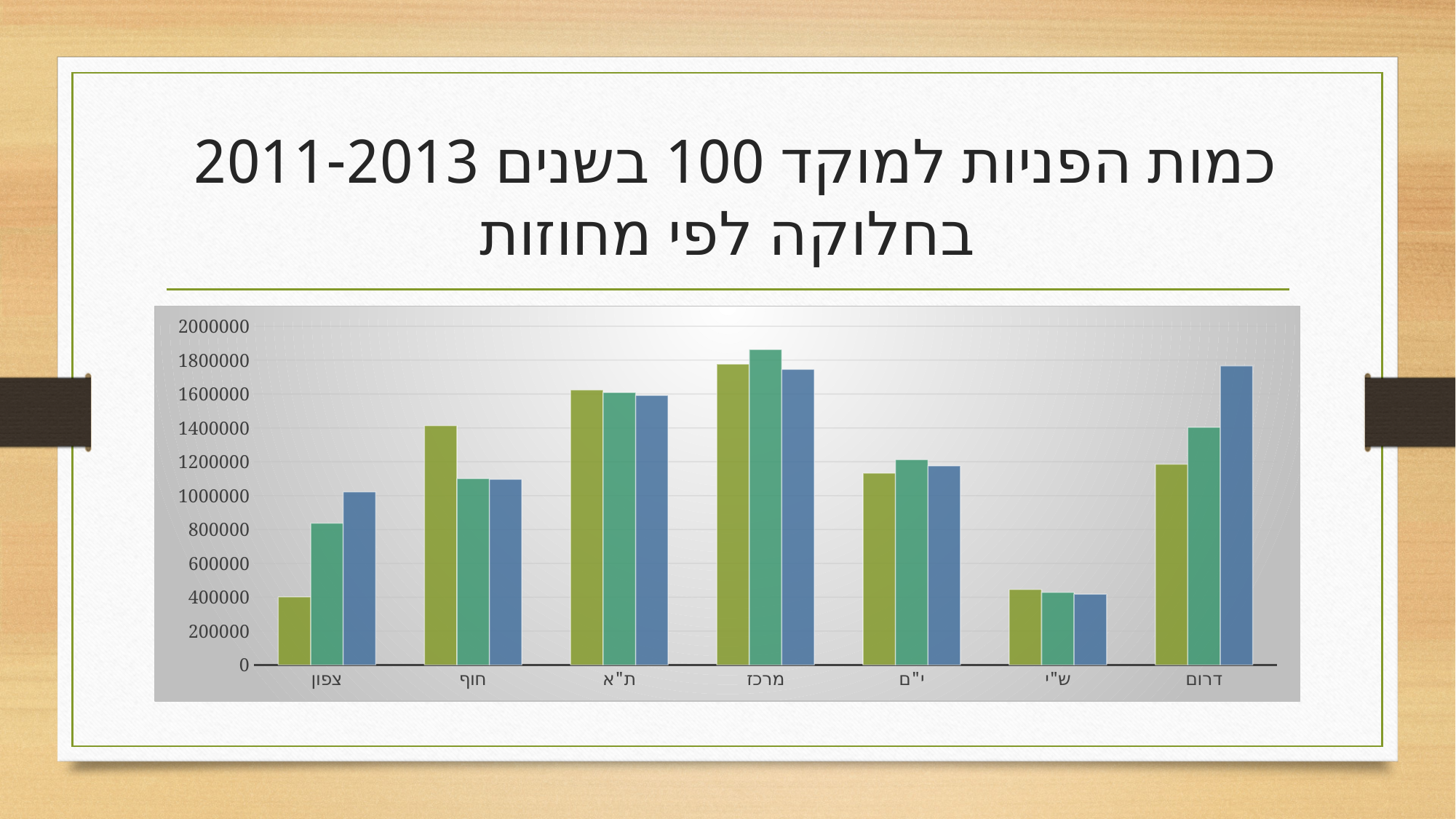
What is the title of the slide containing the chart? כמות הפניות למוקד 100 בשנים 2011-2013 בחלוקה לפי מחוזות Is the value of the middle (teal) bar for מרכז greater or less than 1600000? greater How many bars are plotted for each category in the chart? 3 Which category contains the tallest bar in the chart? מרכז Which category has the lowest middle (teal) bar in the chart? ש"י Is the value of the first (olive) bar for חוף greater or less than 1200000? greater Which is larger: the first (olive) bar for צפון or the first (olive) bar for דרום? דרום What kind of chart is shown on the slide? bar chart Do the three bars for צפון rise or fall from left to right? rise How many categories are shown on the x axis of the chart? 7 Is the value of the third (blue) bar for דרום greater or less than 1600000? greater